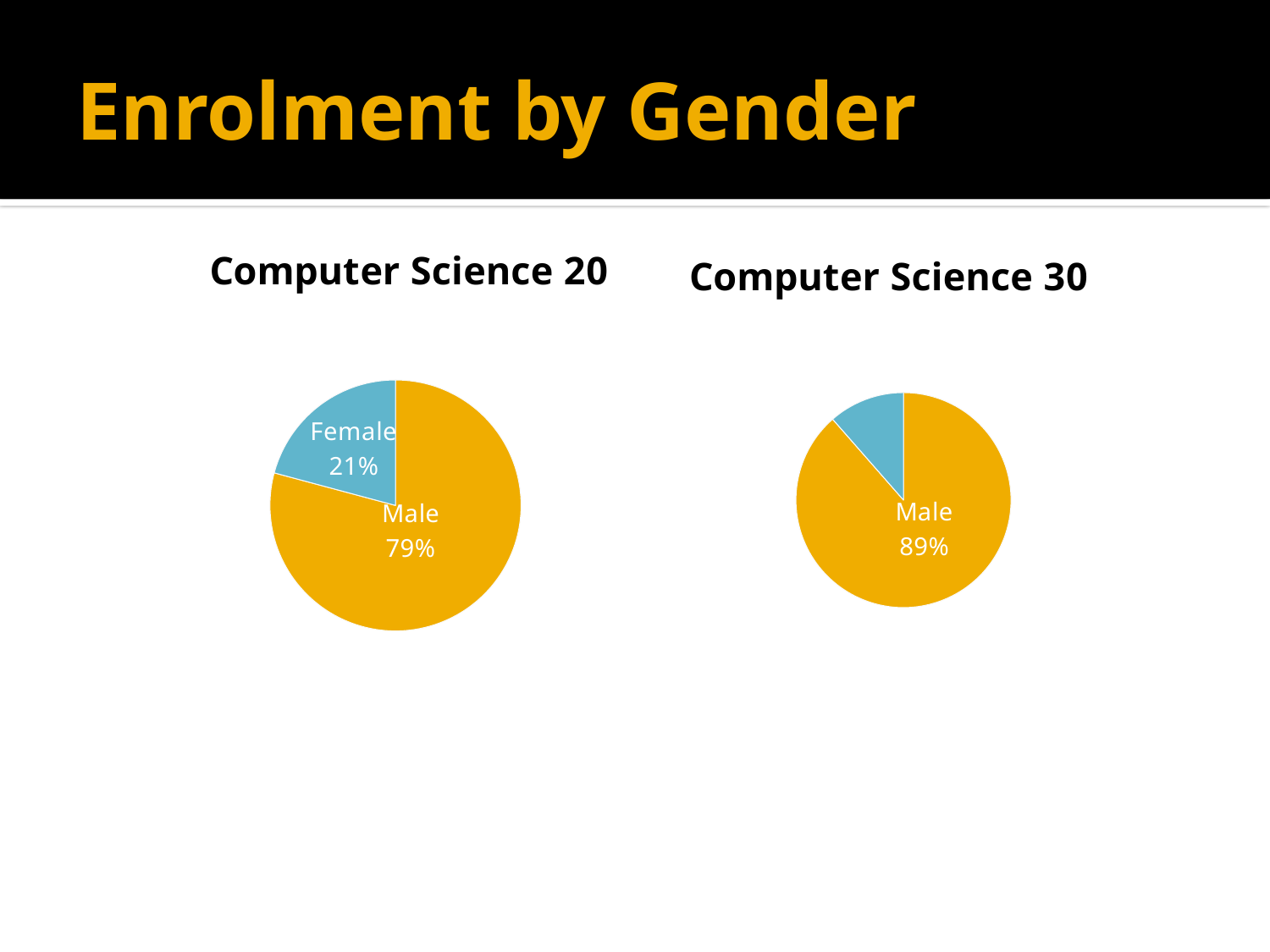
In the Computer Science 20 chart, what share of enrolment is Female? 21% In the Computer Science 20 chart, by how many percentage points does the Male share exceed the Female share? 58 percentage points In the Computer Science 20 chart, which slice is the smallest? Female In the Computer Science 20 chart, what share of enrolment is Male? 79% In the Computer Science 20 chart, what colour is the Female slice? Blue In the Computer Science 30 chart, is the Male share greater or less than 80%? greater How many slices does the Computer Science 30 pie chart have? 2 What is the title of the chart on the left of the slide? Computer Science 20 Is the Male share larger in the Computer Science 20 chart or the Computer Science 30 chart? Computer Science 30 In the Computer Science 20 chart, which slice is the largest? Male In the Computer Science 30 chart, what share of enrolment is Male? 89% What type of chart is used for Computer Science 20? Pie chart